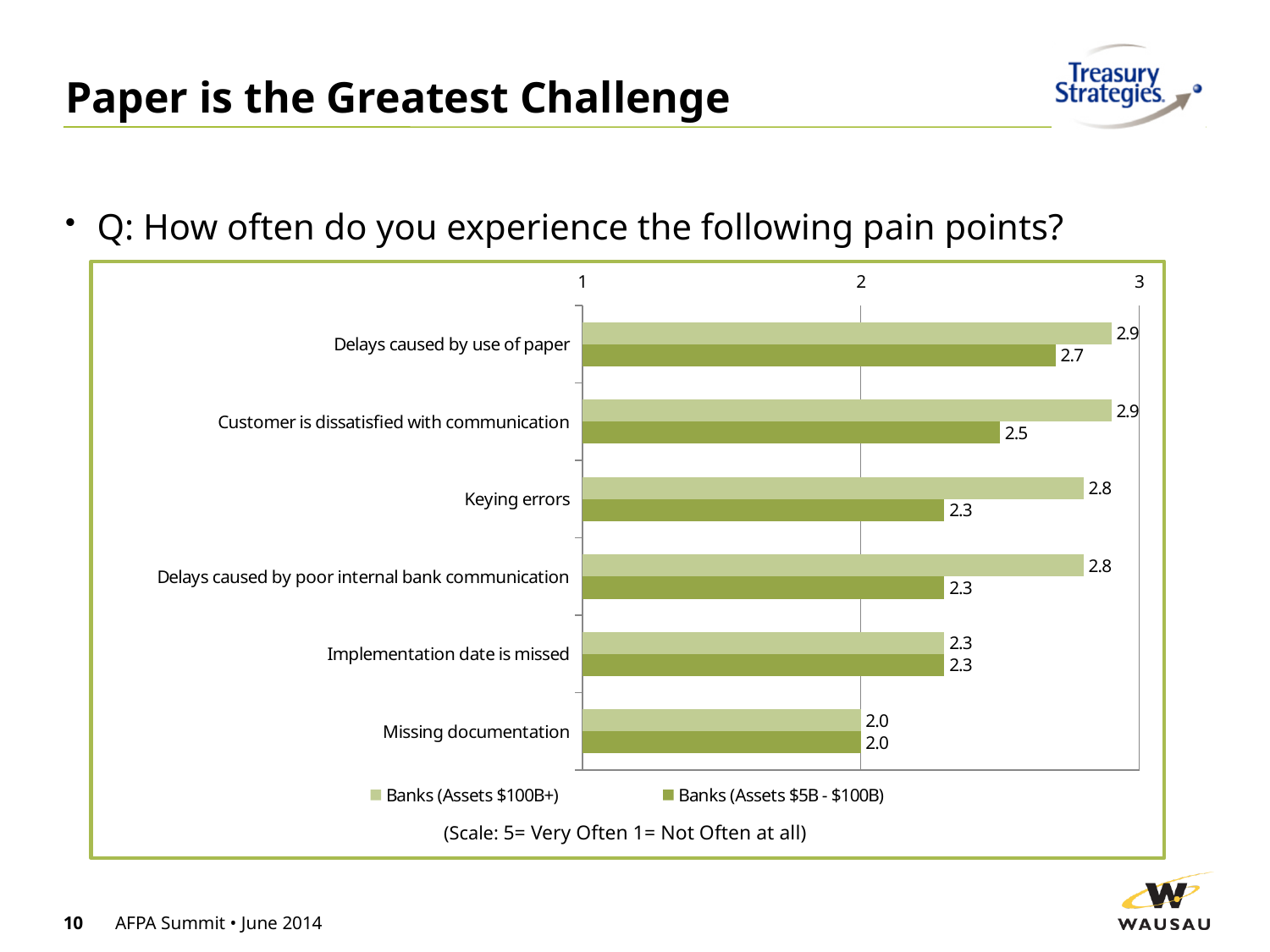
What is the value for Keying errors for Banks (Assets $5B - $100B)? 2.3 How many pain point categories are shown in the chart? 6 What scale does the chart note say the values are on? 5= Very Often 1= Not Often at all Which category has the highest value for Banks (Assets $5B - $100B)? Delays caused by use of paper How many series does the legend list? 2 What is the value for Customer is dissatisfied with communication for Banks (Assets $5B - $100B)? 2.5 Which category has the lowest value for Banks (Assets $100B+)? Missing documentation What is the difference between the two series for Customer is dissatisfied with communication? 0.4 What is the value for Delays caused by use of paper for Banks (Assets $100B+)? 2.9 What is the difference between the two series for Delays caused by poor internal bank communication? 0.5 For Keying errors, which series has the larger value: Banks (Assets $100B+) or Banks (Assets $5B - $100B)? Banks (Assets $100B+) What kind of chart is shown on the slide? Bar chart